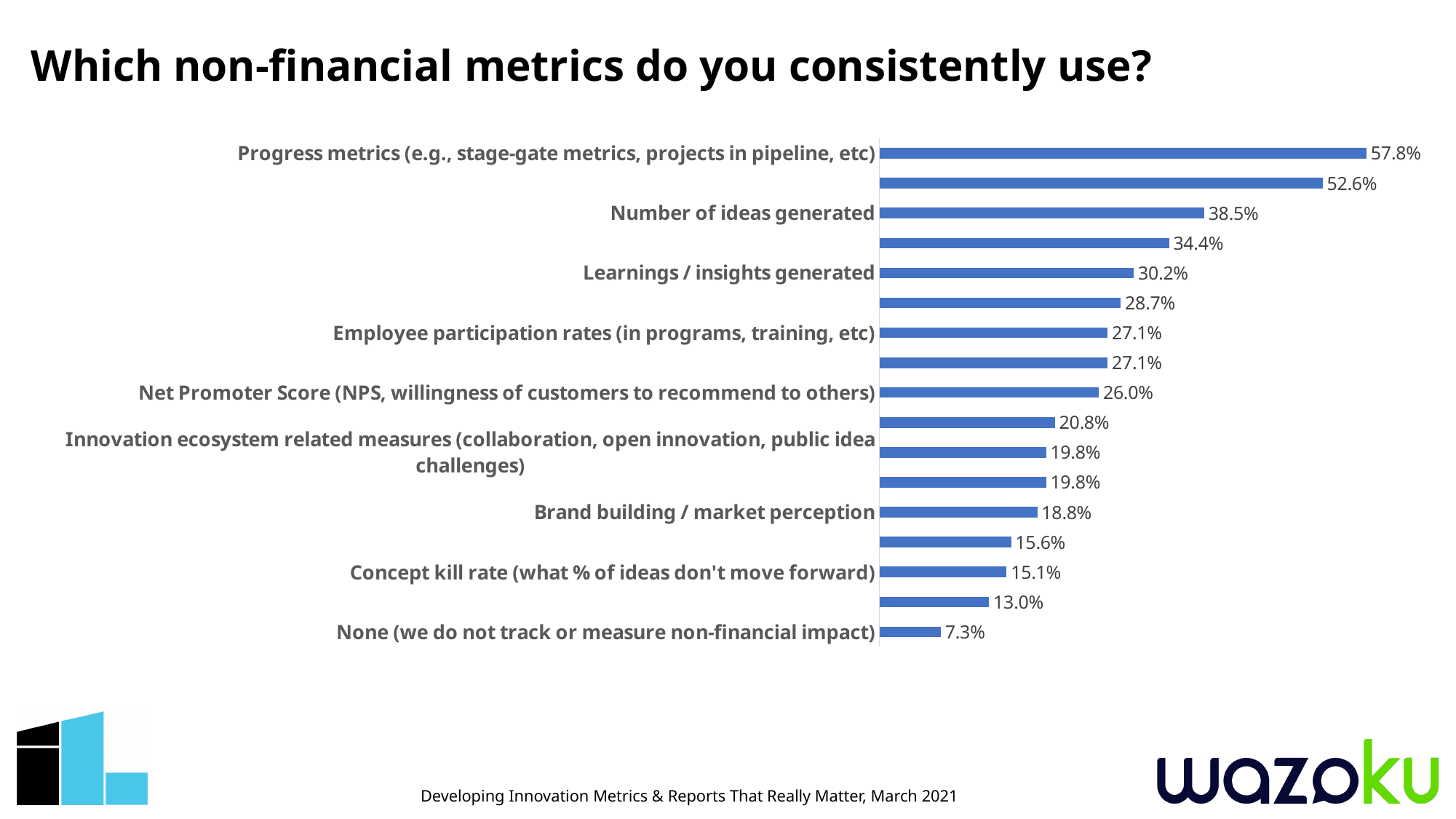
What is the value for Learnings / insights generated? 30.2% What is the value for Number of ideas generated? 38.5% How many bars are plotted in the chart? 17 What is the value for Net Promoter Score (NPS, willingness of customers to recommend to others)? 26.0% Which labelled category has the highest value? Progress metrics (e.g., stage-gate metrics, projects in pipeline, etc) What is the value for Progress metrics (e.g., stage-gate metrics, projects in pipeline, etc)? 57.8% What type of chart is shown on the slide? bar chart Which labelled category has the lowest value? None (we do not track or measure non-financial impact) What is the difference between the values for Number of ideas generated and Learnings / insights generated? 8.3% What is the value for None (we do not track or measure non-financial impact)? 7.3% Which is larger, the value for Employee participation rates (in programs, training, etc) or the value for Concept kill rate (what % of ideas don't move forward)? Employee participation rates (in programs, training, etc) What is the value for Brand building / market perception? 18.8%